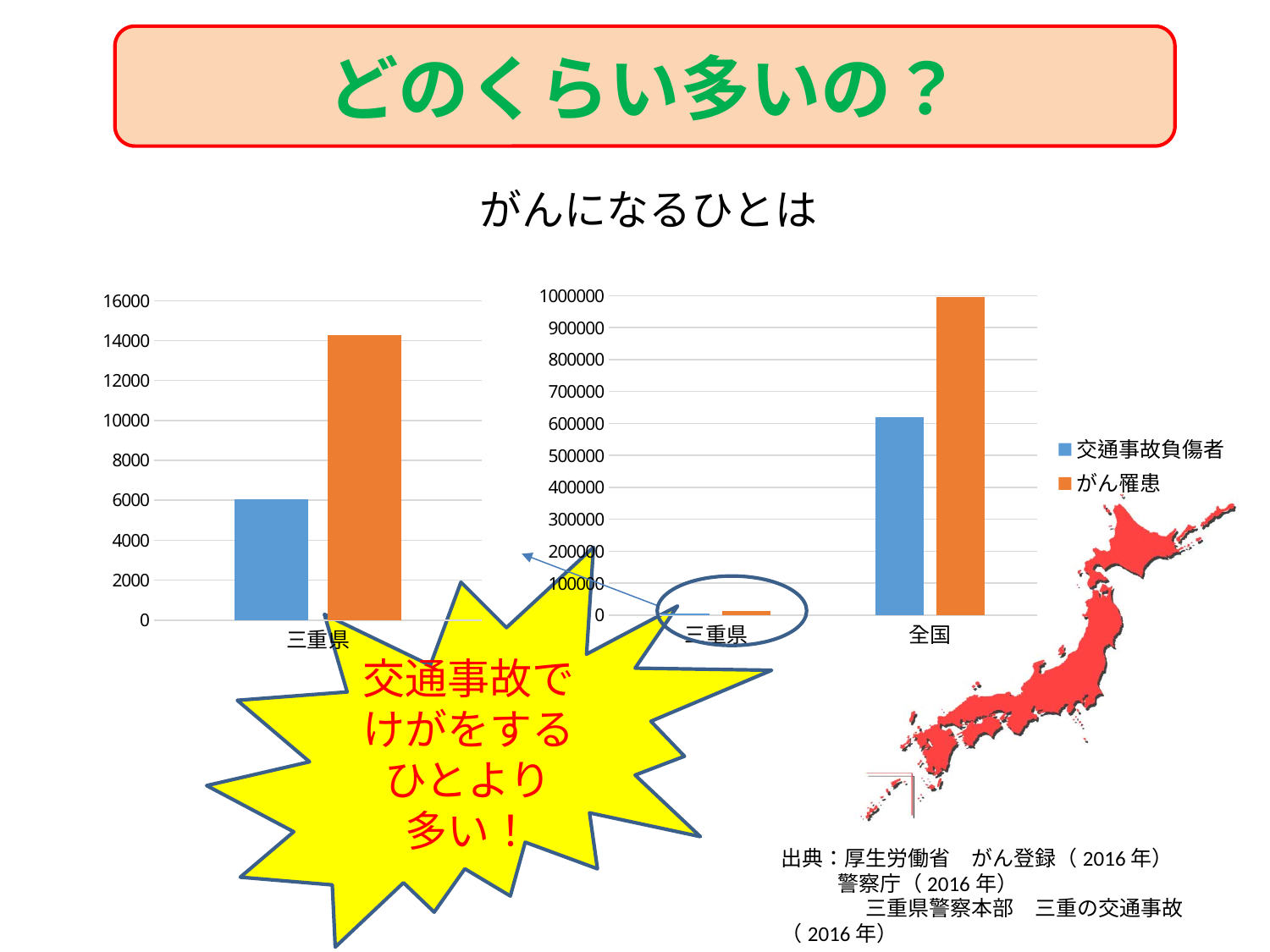
On the right chart, is the value for 交通事故負傷者 in 三重県 greater or less than 100000? less On the left chart, is the value for がん罹患 in 三重県 greater or less than 14000? greater On the right chart, which category has the highest がん罹患 value? 全国 On the right chart, which is larger for 全国, 交通事故負傷者 or がん罹患? がん罹患 How many categories are shown on the x axis of the right chart? 2 On the right chart, is the value for 交通事故負傷者 in 全国 greater or less than 600000? greater What kind of chart is the left chart? bar chart On the right chart, which category has the lowest 交通事故負傷者 value? 三重県 On the left chart, which series has the taller bar for 三重県, 交通事故負傷者 or がん罹患? がん罹患 How many series does the legend list? 2